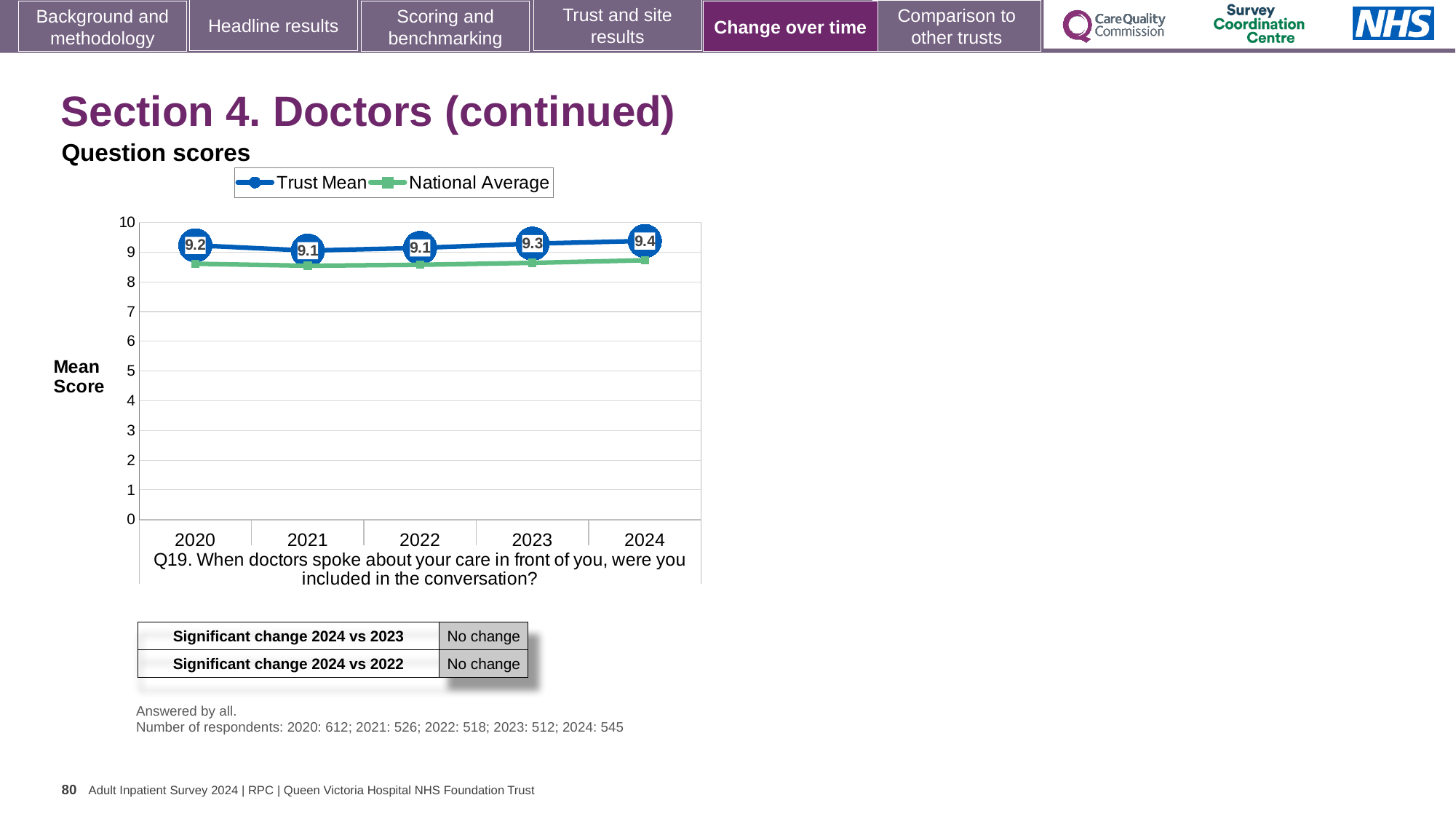
What is the Trust Mean score for 2020? 9.2 Which is larger, the Trust Mean score in 2023 or in 2021? 2023 In which year is the Trust Mean score highest? 2024 What is the difference between the Trust Mean score in 2024 and in 2022? 0.3 How many years are shown on the x axis of the chart? 5 Does the Trust Mean score rise or fall from 2022 to 2024? rise Is the National Average value for 2021 greater or less than 9? less Is the National Average value for 2024 greater or less than 8? greater What is the Trust Mean score for 2024? 9.4 What kind of chart is shown on the slide? line chart How many series does the chart legend list? 2 What is the Trust Mean score for 2021? 9.1